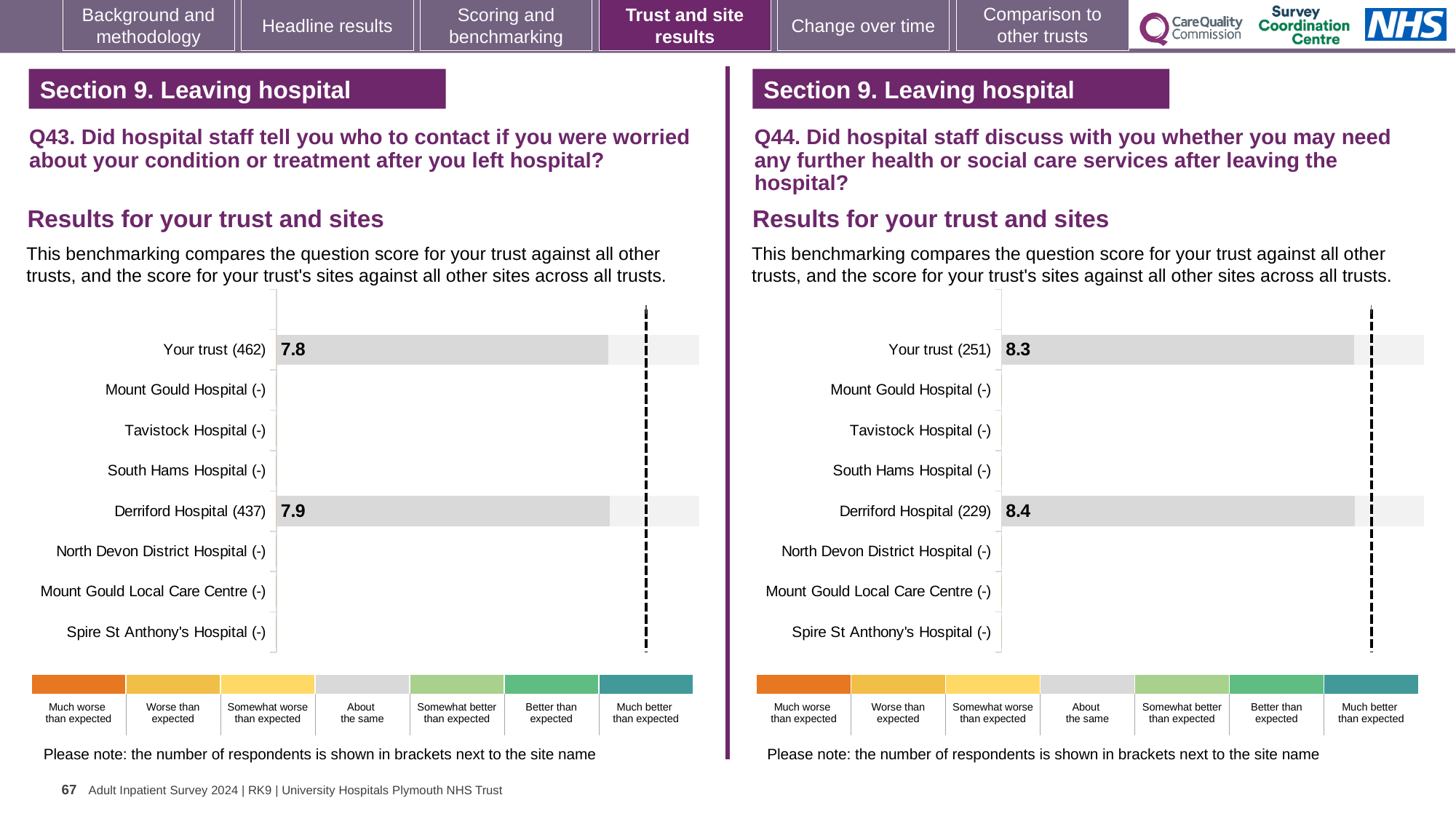
In the Q44 chart on the right, what is the score for Derriford Hospital? 8.4 In the Q43 chart on the left, what is the difference between the Derriford Hospital score and the Your trust score? 0.1 In the Q44 chart on the right, what is the difference between the Derriford Hospital score and the Your trust score? 0.1 In the Q44 chart on the right, what is the score for Your trust? 8.3 In the Q43 chart on the left, what is the score for Derriford Hospital? 7.9 How many site/trust categories are listed on the y axis of the Q43 chart on the left? 8 In the Q43 chart on the left, how many categories have a plotted bar with a score? 2 In the Q43 chart on the left, how many respondents are shown in brackets for Your trust? 462 In the Q44 chart on the right, how many respondents are shown in brackets for Derriford Hospital? 229 What kind of chart is used for the Q44 results on the right? Bar chart In the Q44 chart on the right, which category label appears directly below Your trust? Mount Gould Hospital (-) In the Q43 chart on the left, what is the score for Your trust? 7.8